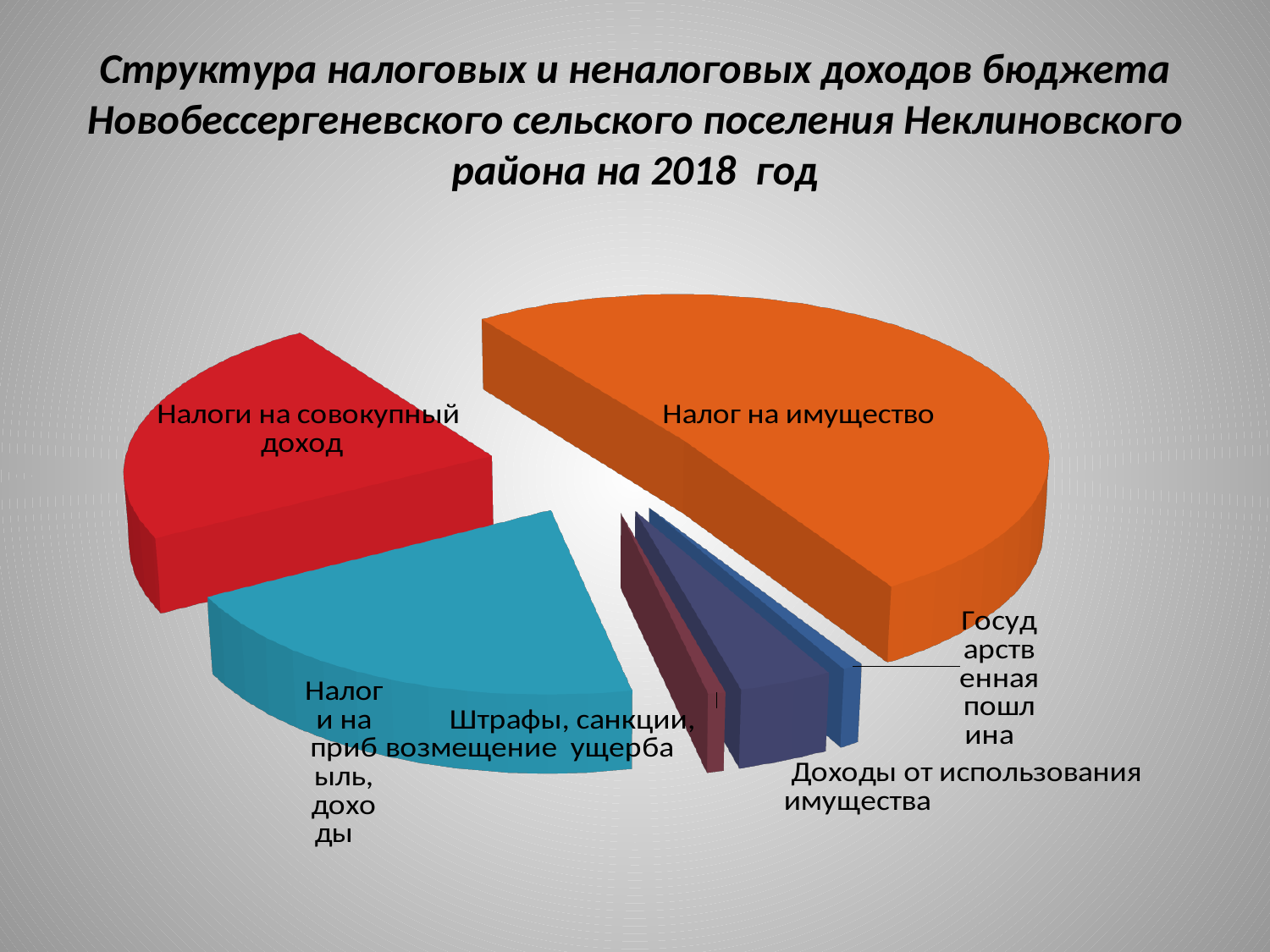
Which is larger: the slice for Налог на имущество or the slice for Доходы от использования имущества? Налог на имущество Which is larger: the slice for Налоги на совокупный доход or the slice for Государственная пошлина? Налоги на совокупный доход Which is larger: the slice for Налог на прибыль, доходы or the slice for Штрафы, санкции, возмещение ущерба? Налог на прибыль, доходы Which year does the chart title say the budget revenue structure refers to? 2018 How many slices does the pie chart have? 6 Which category has the largest slice of the pie chart? Налог на имущество What kind of chart is shown on the slide? pie chart What colour is the slice for Налог на имущество? orange